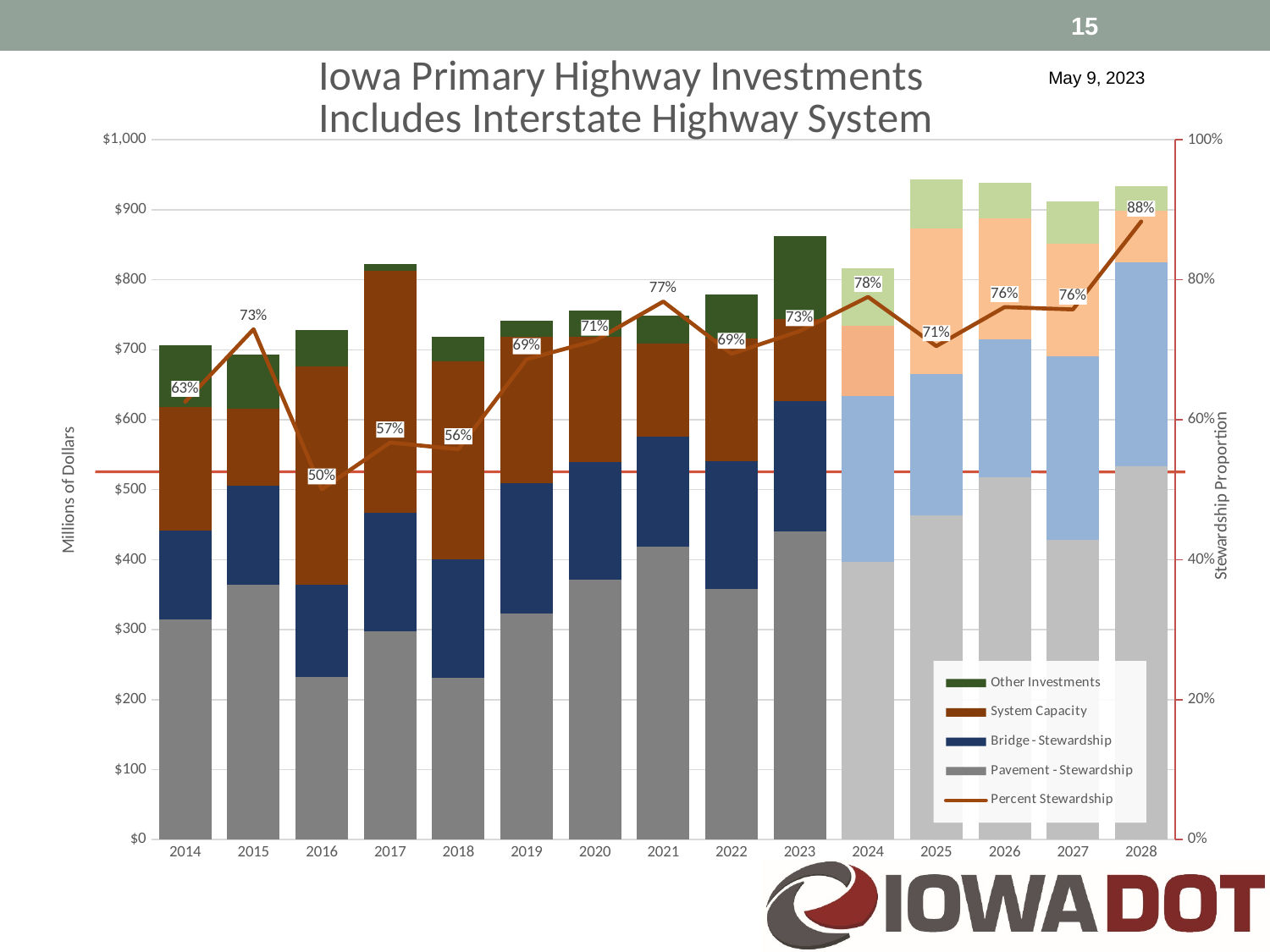
How many series does the legend list? 5 What is the label of the left vertical axis? Millions of Dollars What is the difference between the Percent Stewardship values for 2028 and 2016? 38 percentage points Is the total investment bar for 2016 greater or less than $800? less What is the Percent Stewardship value for 2021? 77% What is the Percent Stewardship value for 2014? 63% Which year has the highest Percent Stewardship value? 2028 What is the Percent Stewardship value for 2028? 88% Which year has a higher Percent Stewardship value, 2021 or 2024? 2024 Which year has the lowest Percent Stewardship value? 2016 Is the total investment bar for 2025 greater or less than $900? greater How many years are shown on the x axis? 15